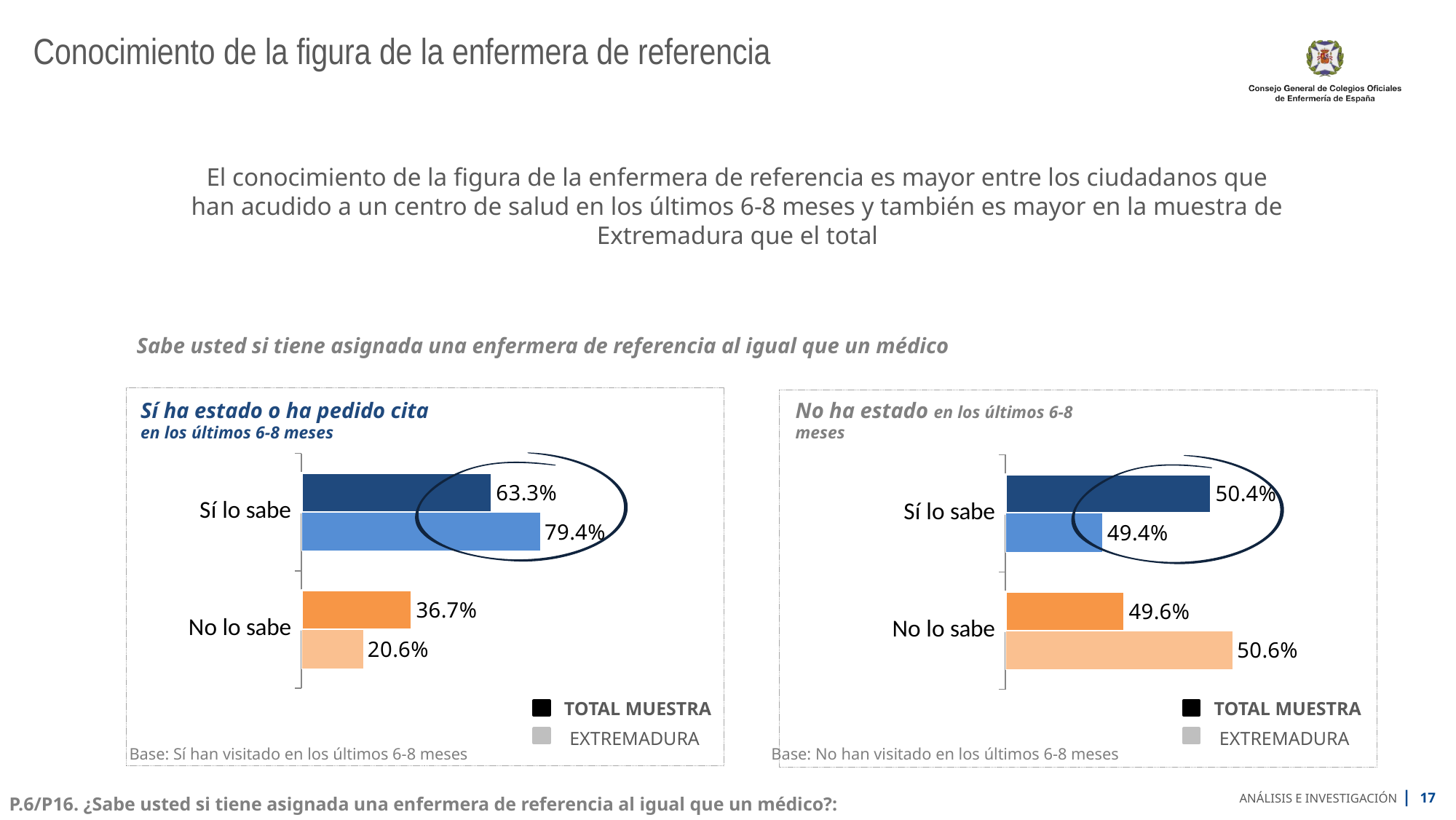
How many series does the legend of the right chart (No ha estado) list? 2 In the left chart (Sí ha estado o ha pedido cita), which bar has the lowest value? No lo sabe, EXTREMADURA (20.6%) In the left chart (Sí ha estado o ha pedido cita), what is the EXTREMADURA value for 'No lo sabe'? 20.6% In the left chart (Sí ha estado o ha pedido cita), what is the difference between the TOTAL MUESTRA and EXTREMADURA values for 'No lo sabe'? 16.1% In the left chart (Sí ha estado o ha pedido cita), what is the difference between the EXTREMADURA and TOTAL MUESTRA values for 'Sí lo sabe'? 16.1% In the left chart (Sí ha estado o ha pedido cita), what is the TOTAL MUESTRA value for 'Sí lo sabe'? 63.3% In the left chart (Sí ha estado o ha pedido cita), which is larger for 'Sí lo sabe': TOTAL MUESTRA or EXTREMADURA? EXTREMADURA In the right chart (No ha estado), what is the EXTREMADURA value for 'No lo sabe'? 50.6% In the left chart (Sí ha estado o ha pedido cita), what is the EXTREMADURA value for 'Sí lo sabe'? 79.4% In the right chart (No ha estado), what is the TOTAL MUESTRA value for 'Sí lo sabe'? 50.4% What type of chart is the left chart (Sí ha estado o ha pedido cita)? Bar chart In the right chart (No ha estado), what is the difference between the TOTAL MUESTRA and EXTREMADURA values for 'Sí lo sabe'? 1.0%